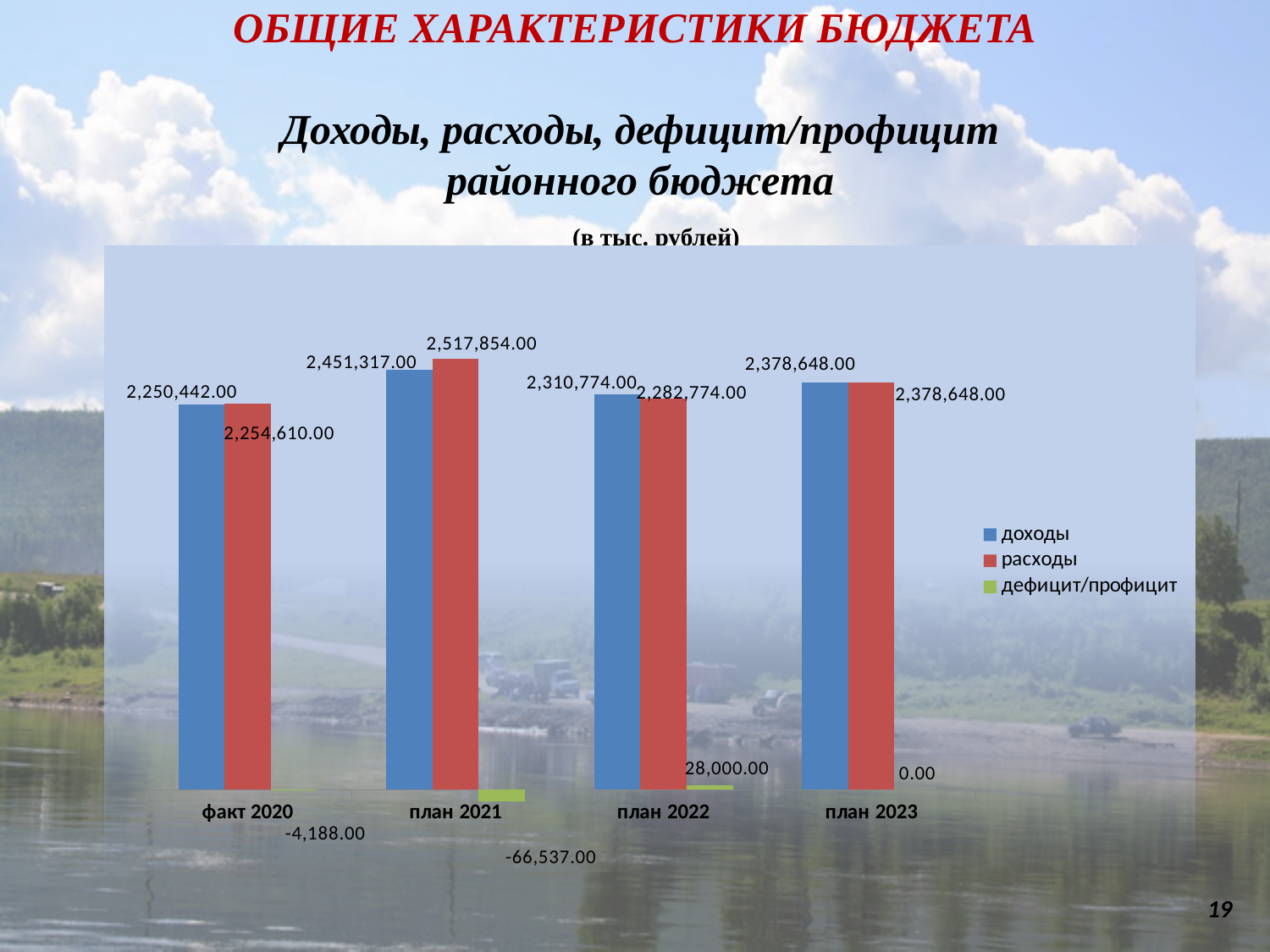
Which category has the highest value of расходы? план 2021 What is the difference between расходы and доходы for план 2021? 66,537.00 What is the value of дефицит/профицит for план 2021? -66,537.00 What type of chart is shown on the slide? bar chart Which is larger for план 2022: доходы or расходы? доходы How many series does the legend list? 3 Which legend entry is shown in green? дефицит/профицит What is the value of расходы for план 2021? 2,517,854.00 What is the value of доходы for факт 2020? 2,250,442.00 How many categories are shown on the x axis? 4 Which category has the lowest value of доходы? факт 2020 What is the value of дефицит/профицит for план 2022? 28,000.00